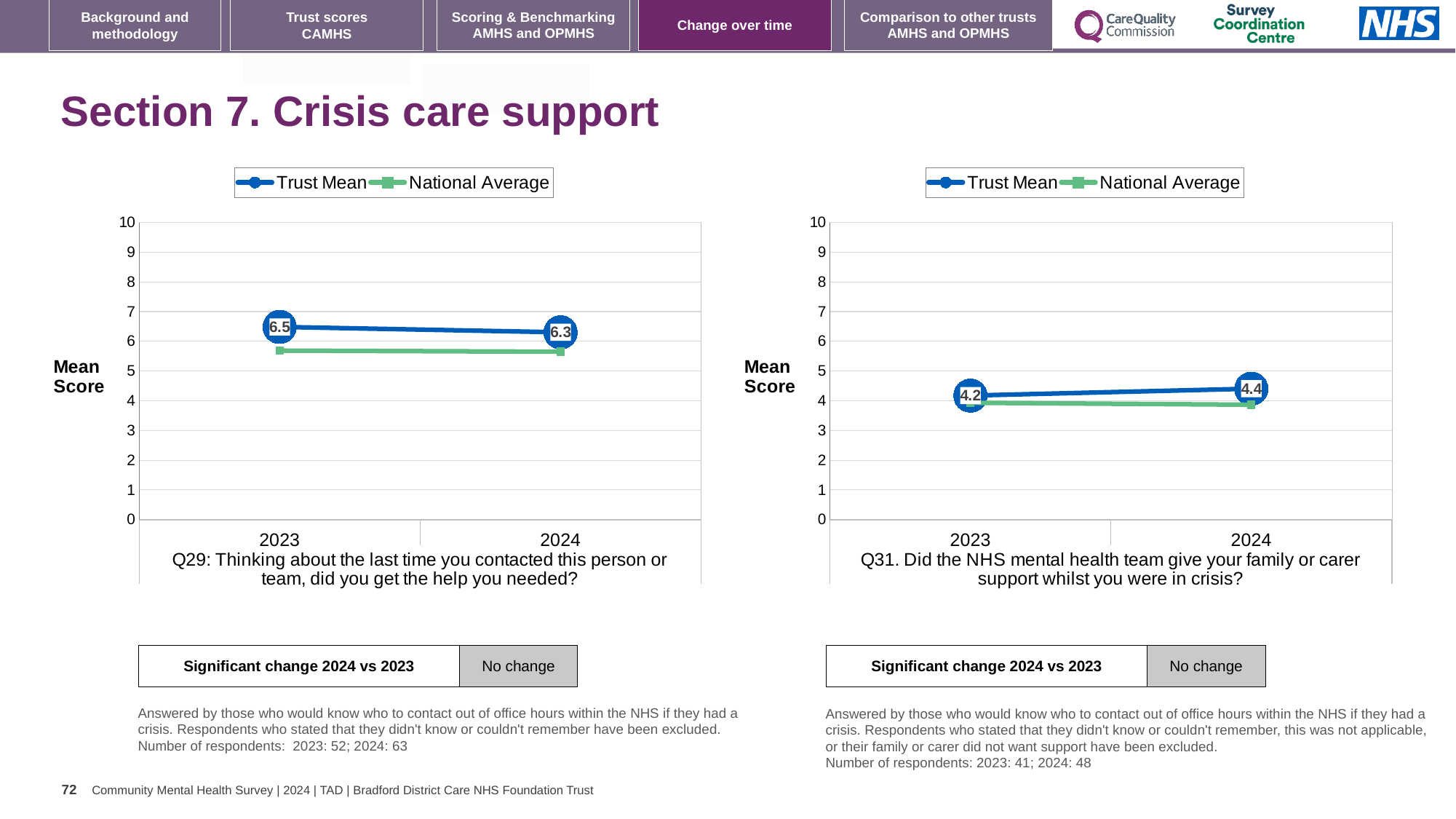
In the Q29 chart on the left, what is the Trust Mean score for 2023? 6.5 How many series does the legend of the Q31 chart on the right list? 2 What type of chart is used for Q29 on the left? line chart In the Q29 chart on the left, does the Trust Mean rise or fall from 2023 to 2024? fall In the Q31 chart on the right, does the Trust Mean rise or fall from 2023 to 2024? rise How many years are shown on the x axis of the Q29 chart on the left? 2 In the Q31 chart on the right, what is the Trust Mean score for 2024? 4.4 In the Q29 chart on the left, is the National Average for 2023 greater or less than 6? less In the Q31 chart on the right, what is the Trust Mean score for 2023? 4.2 In the Q31 chart on the right, which series has the higher value in 2024, Trust Mean or National Average? Trust Mean In the Q29 chart on the left, by how much did the Trust Mean change from 2023 to 2024? 0.2 In the Q29 chart on the left, what is the Trust Mean score for 2024? 6.3